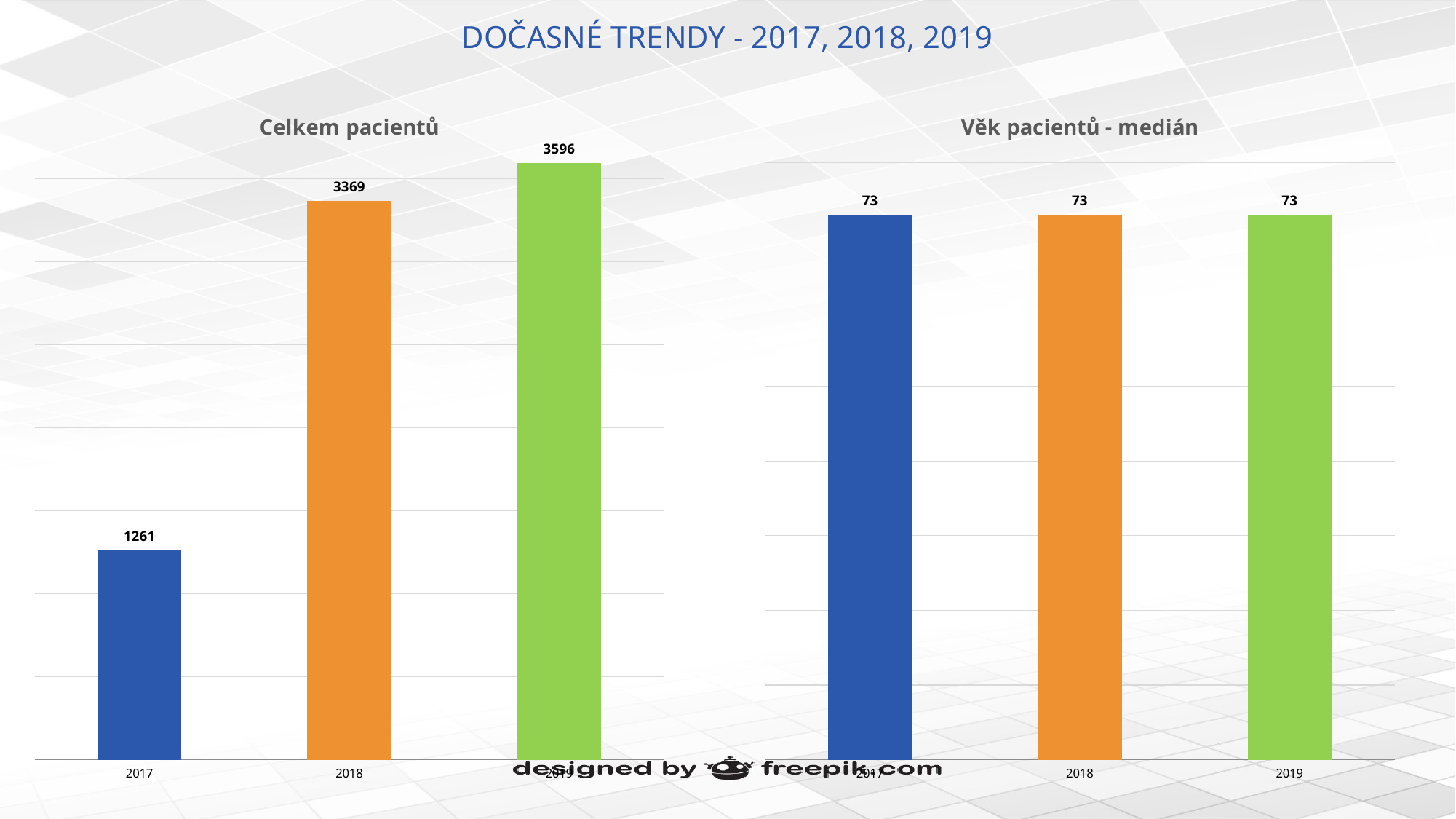
In the 'Celkem pacientů' chart, what is the value for 2017? 1261 What kind of chart is the 'Celkem pacientů' chart? bar chart In the 'Celkem pacientů' chart, which year has the lowest value? 2017 In the 'Celkem pacientů' chart, what is the difference between the 2018 and 2017 values? 2108 In the 'Celkem pacientů' chart, which is larger, the value for 2017 or the value for 2018? 2018 In the 'Celkem pacientů' chart, do the values rise or fall from 2017 to 2019? rise In the 'Celkem pacientů' chart, what is the difference between the 2019 and 2018 values? 227 In the 'Věk pacientů - medián' chart, what is the value for 2019? 73 What is the title of the chart on the right side of the slide? Věk pacientů - medián In the 'Celkem pacientů' chart, what is the value for 2018? 3369 In the 'Celkem pacientů' chart, which year has the highest value? 2019 How many bars are in the 'Věk pacientů - medián' chart? 3